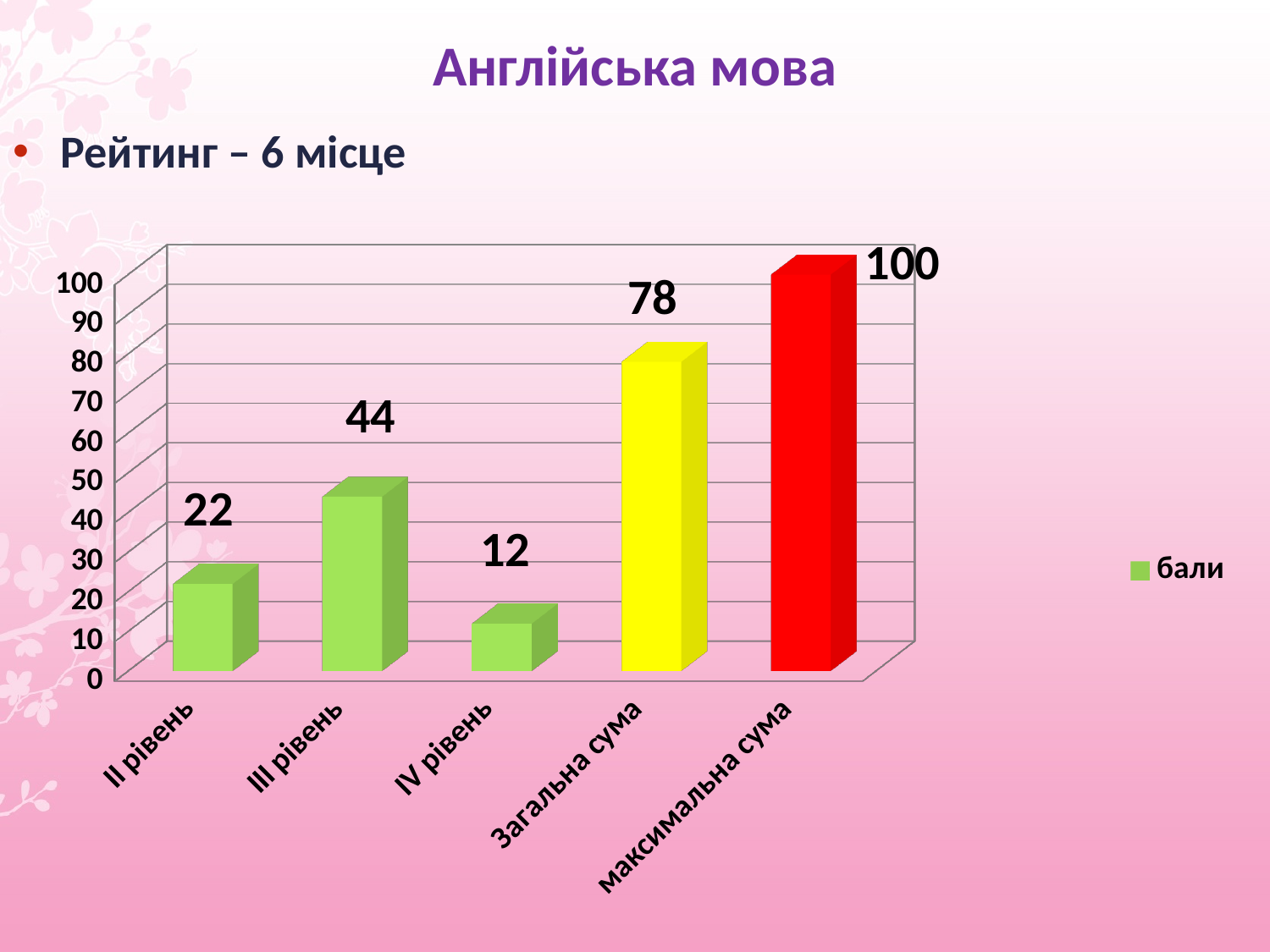
What is the value for ІІІ рівень? 44 How many series does the legend list? 1 What kind of chart is shown on the slide? bar chart What is the value for Загальна сума? 78 Which is larger, the value for ІІ рівень or the value for ІІІ рівень? ІІІ рівень Which category has the highest value? максимальна сума What is the difference between the values for максимальна сума and Загальна сума? 22 What is the name of the series in the legend? бали Which category has the lowest value? ІV рівень What is the value for ІІ рівень? 22 What is the value for ІV рівень? 12 How many categories are shown on the x axis? 5